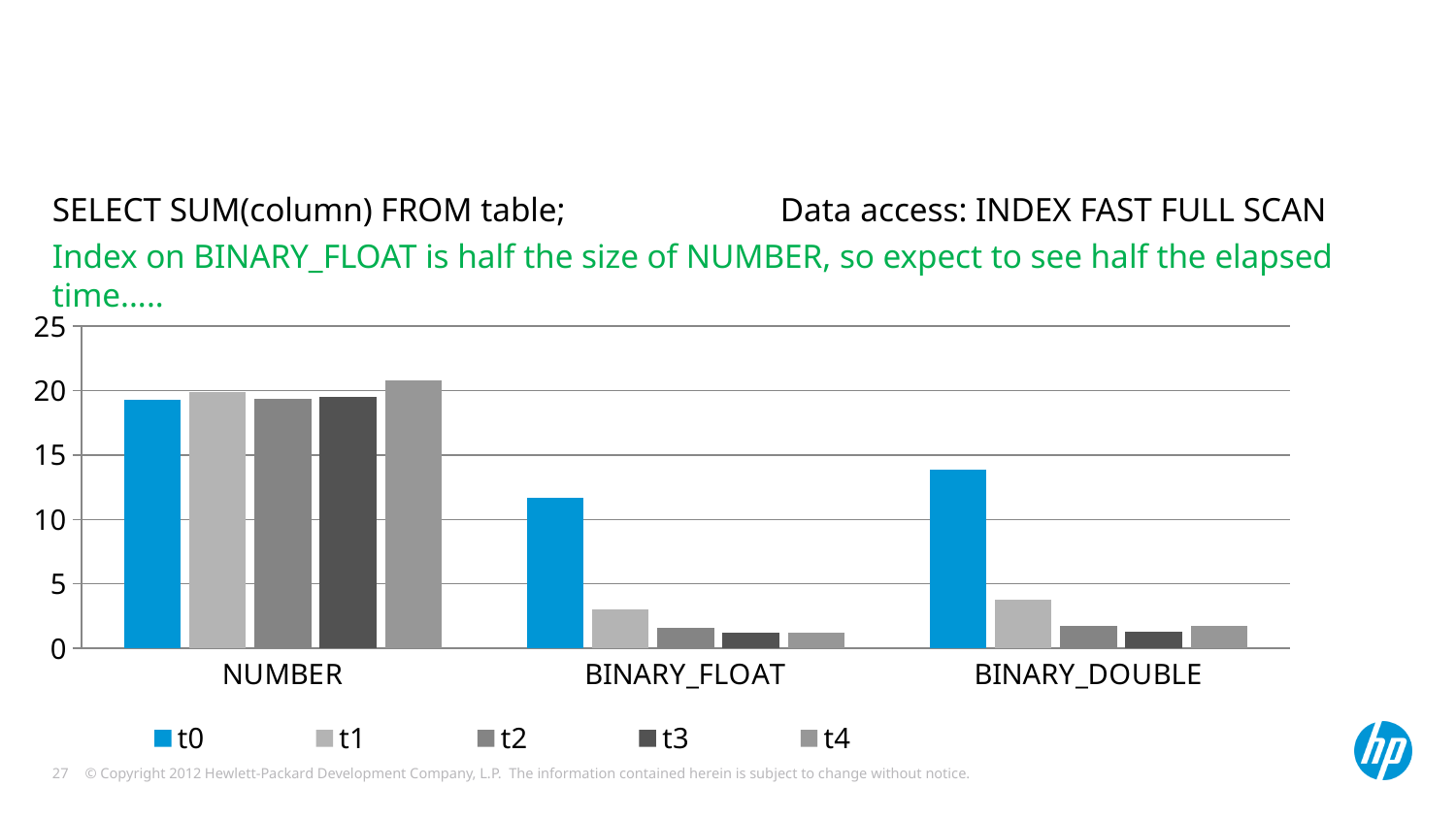
Is the t0 value for BINARY_FLOAT greater or less than 10? greater Is the t0 value for NUMBER greater or less than 15? greater How many categories are shown on the x axis? 3 Is the t1 value for BINARY_FLOAT greater or less than 5? less What kind of chart is shown on the slide? bar chart How many series does the legend list? 5 What are the series names listed in the legend? t0, t1, t2, t3, t4 Which is larger, the t1 value for NUMBER or the t1 value for BINARY_DOUBLE? NUMBER Which is larger, the t0 value for BINARY_FLOAT or the t0 value for BINARY_DOUBLE? BINARY_DOUBLE Which category has the highest t0 value? NUMBER